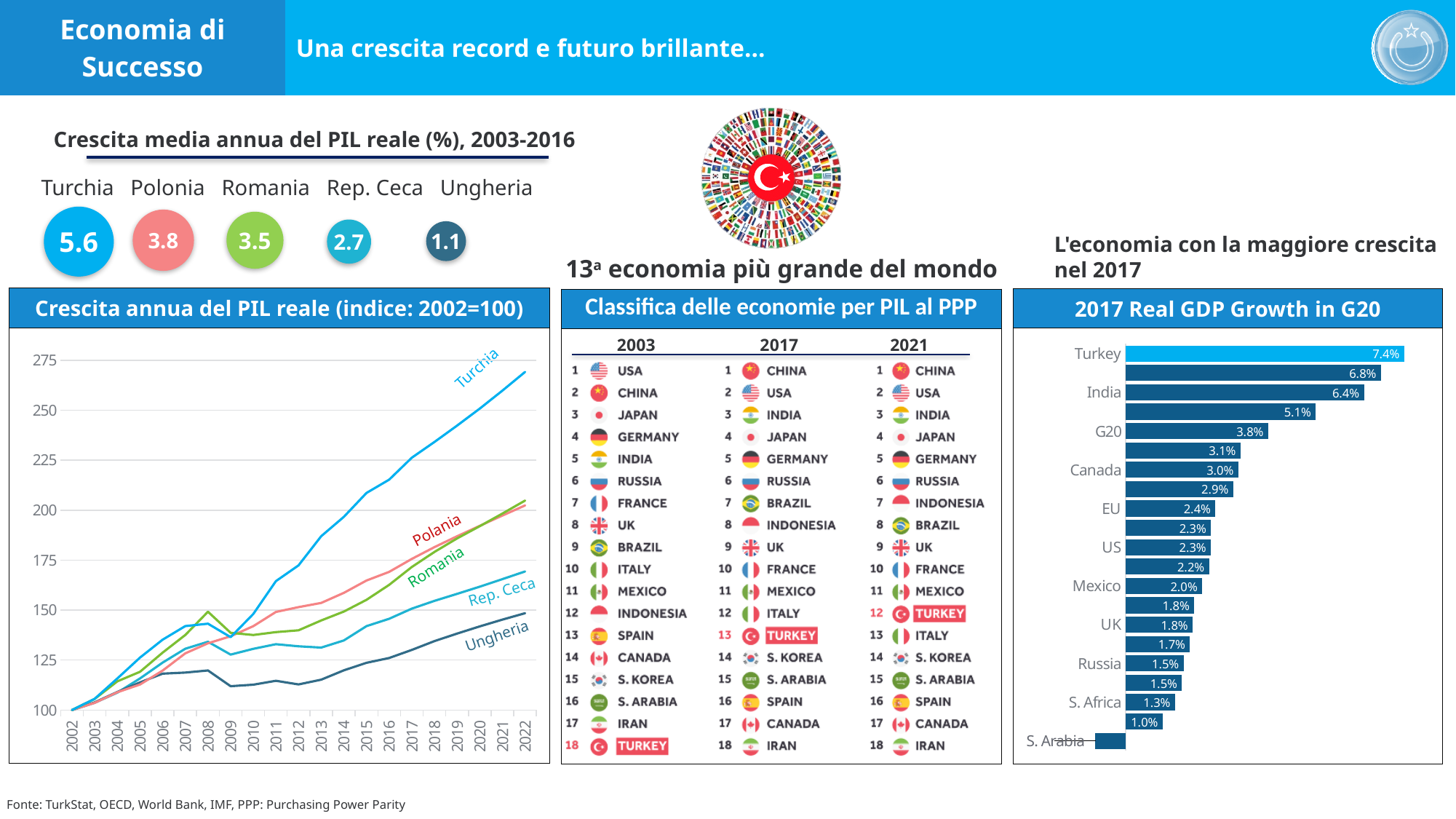
In the chart '2017 Real GDP Growth in G20', what is the value for the G20 bar? 3.8% In the chart '2017 Real GDP Growth in G20', what is the value for Turkey? 7.4% In the chart '2017 Real GDP Growth in G20', which labelled country has the highest value? Turkey In the chart '2017 Real GDP Growth in G20', what is the value for India? 6.4% In the chart 'Crescita annua del PIL reale (indice: 2002=100)', how many series are shown? 5 In the chart '2017 Real GDP Growth in G20', what is the value for Canada? 3.0% In the chart 'Crescita annua del PIL reale (indice: 2002=100)', does the Turchia line rise or fall from 2009 to 2022? rise In the chart '2017 Real GDP Growth in G20', what is the difference between Turkey's value and India's value? 1.0% In the chart 'Crescita annua del PIL reale (indice: 2002=100)', is the value for Turchia in 2022 greater or less than 250? greater In the chart '2017 Real GDP Growth in G20', which is larger, the value for Mexico or the value for UK? Mexico What kind of chart is '2017 Real GDP Growth in G20'? bar chart